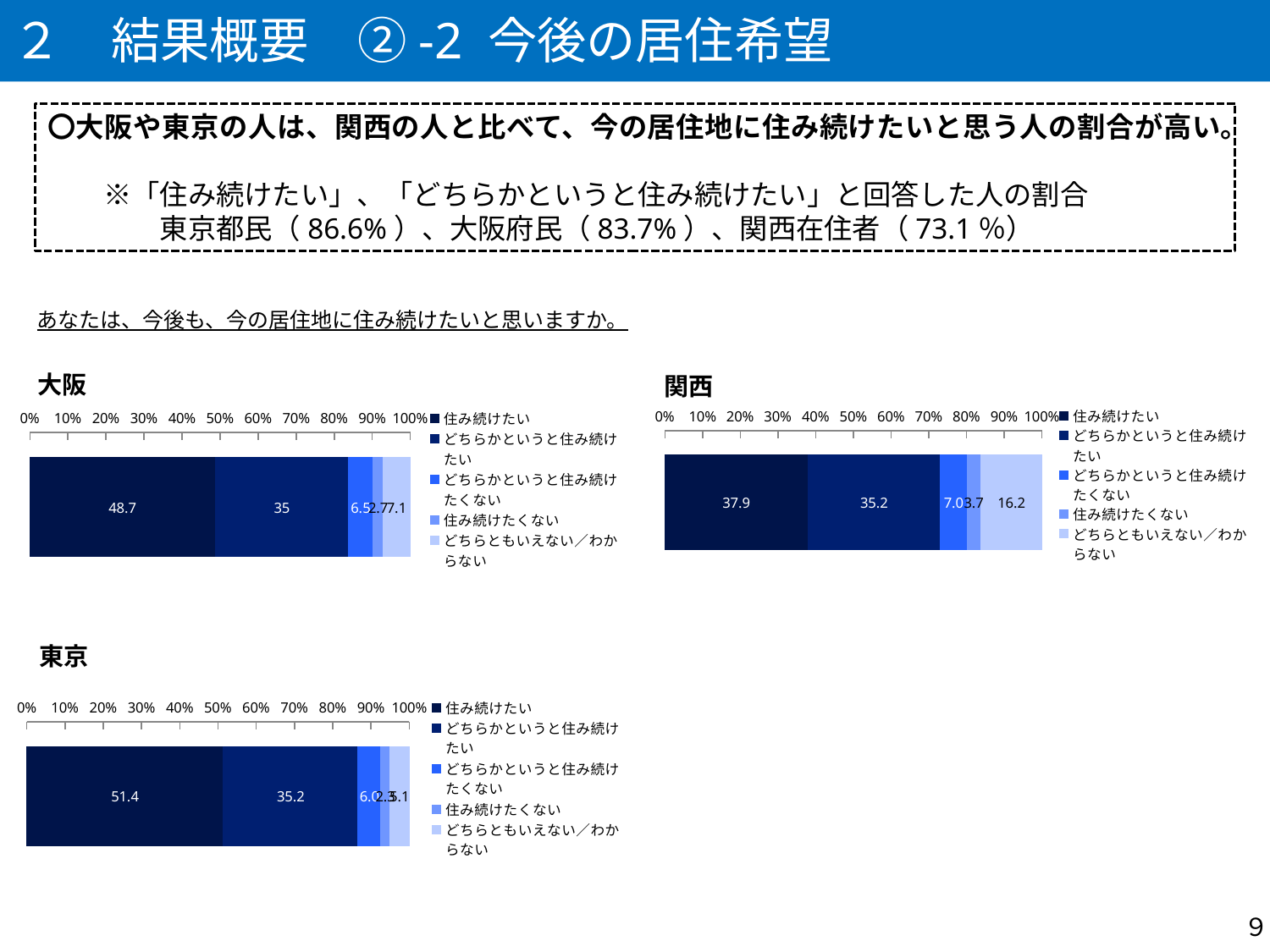
In the 関西 chart, what is the value for 住み続けたい? 37.9 In the 関西 chart, what is the value for 住み続けたくない? 3.7 What kind of chart is the 関西 chart? Stacked bar chart In the 東京 chart, what is the value for どちらかというと住み続けたい? 35.2 In the 東京 chart, what is the value for 住み続けたい? 51.4 In the 大阪 chart, what is the value for 住み続けたい? 48.7 Which is larger: the 住み続けたい value in the 東京 chart or in the 関西 chart? 東京 In the 関西 chart, what is the value for どちらともいえない／わからない? 16.2 In the 大阪 chart, what is the value for どちらかというと住み続けたい? 35 How many series does the legend of the 大阪 chart list? 5 In the 東京 chart, what is the difference between 住み続けたい and どちらかというと住み続けたい? 16.2 In the 関西 chart, which series has the largest value? 住み続けたい